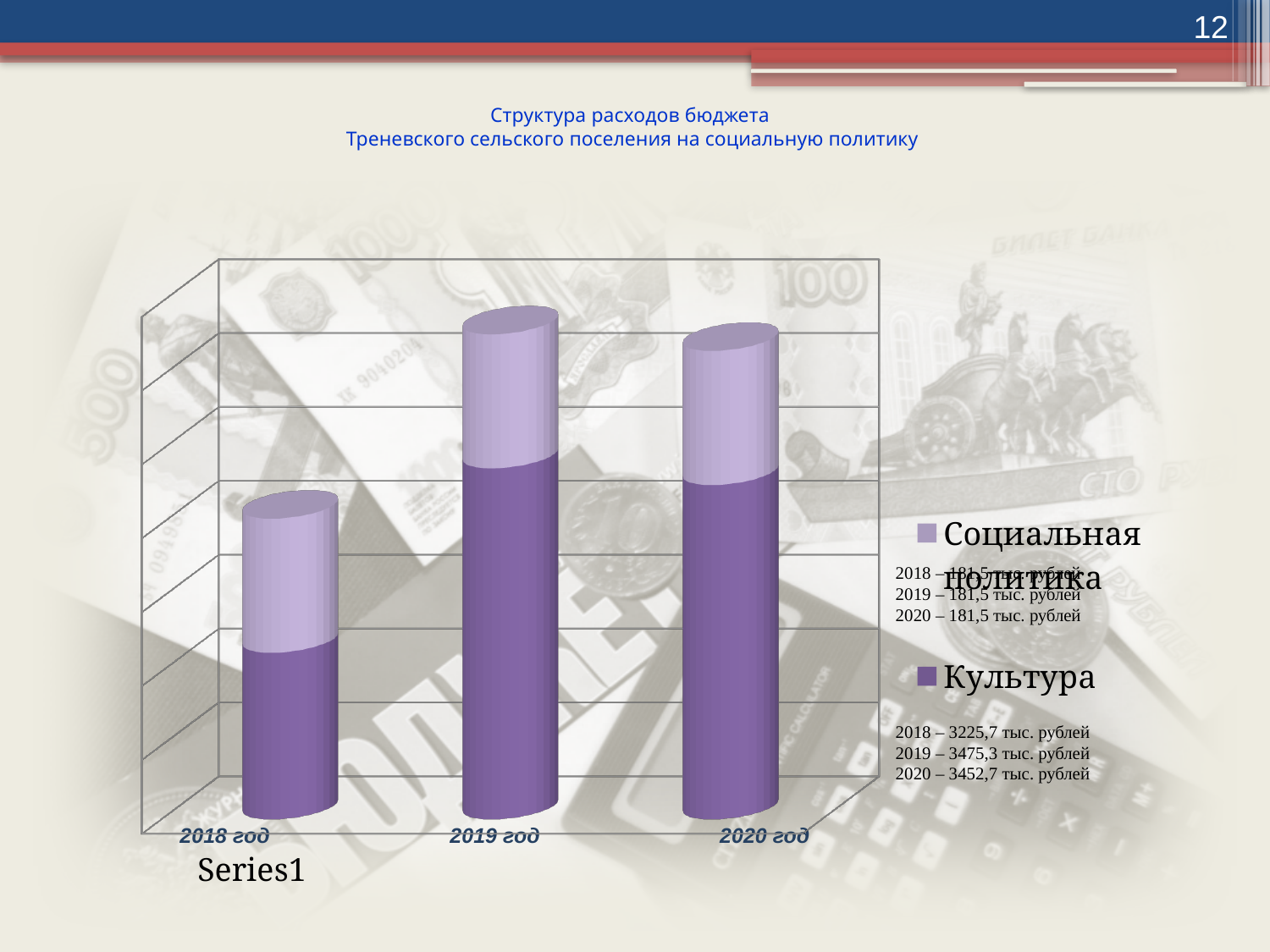
What is the value for Культура in 2020 according to the slide? 3452,7 тыс. рублей What is the value for Культура in 2018 according to the slide? 3225,7 тыс. рублей In which year is the value for Культура the lowest? 2018 What is the value for Культура in 2019 according to the slide? 3475,3 тыс. рублей How many year categories are shown on the x axis of the chart? 3 What are the two series named in the chart legend? Социальная политика and Культура What is the total of the stacked bar for 2019 (Культура plus Социальная политика)? 3656,8 тыс. рублей What is the value for Социальная политика in 2020 according to the slide? 181,5 тыс. рублей By how much did the value for Культура increase from 2018 to 2019? 249,6 тыс. рублей In which year is the value for Культура the highest? 2019 What kind of chart is shown on the slide? Stacked bar chart How many series does the chart legend list? 2